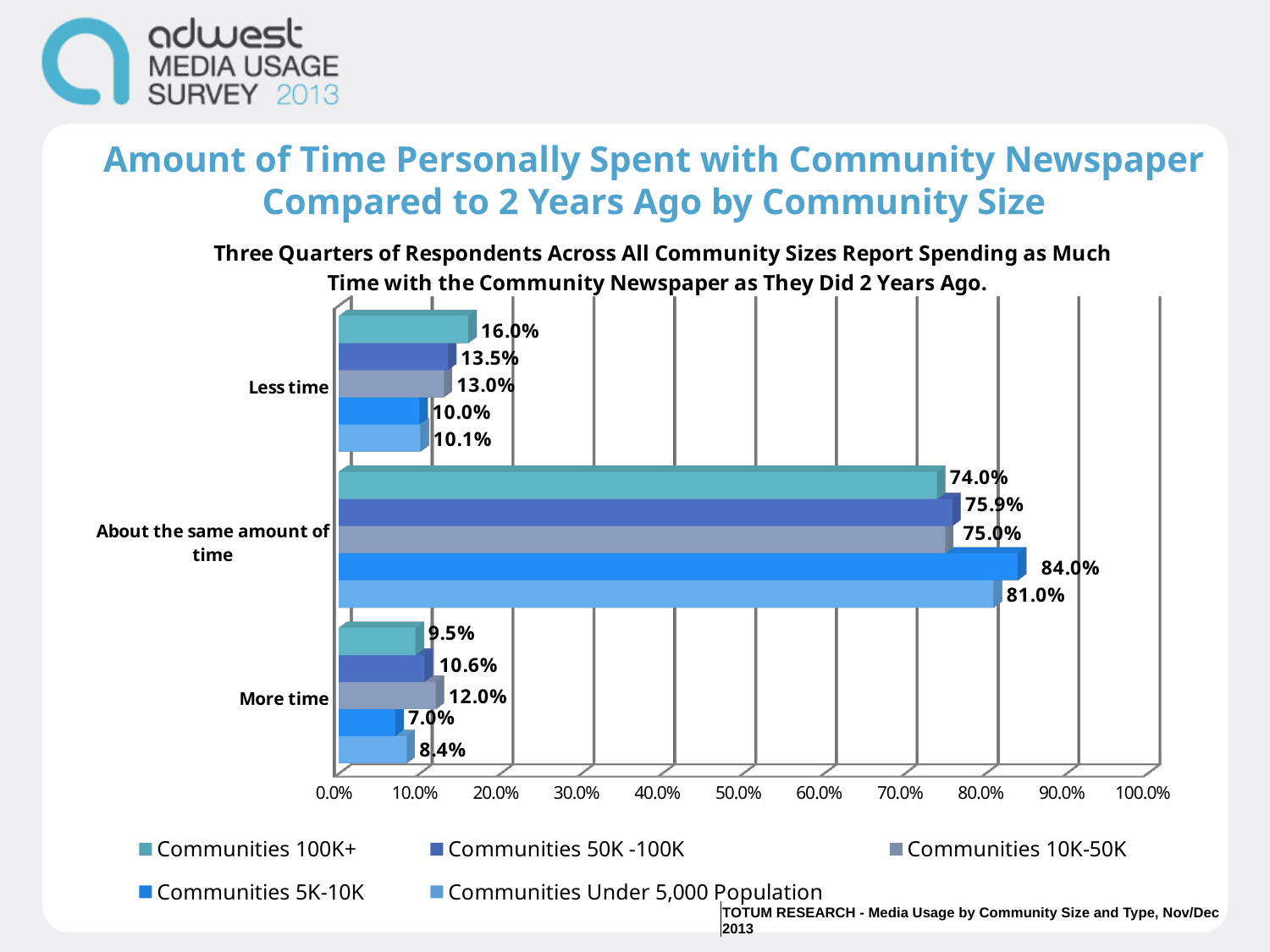
What is the value for Communities 5K-10K in the "About the same amount of time" category? 84.0% How many series does the legend list? 5 In the "Less time" category, which is larger: the value for Communities 100K+ or for Communities 5K-10K? Communities 100K+ What is the highest value shown on the horizontal axis? 100.0% Which community size has the lowest value in the "More time" category? Communities 5K-10K What is the difference between the Communities 5K-10K and Communities 100K+ values in the "About the same amount of time" category? 10.0% How many response categories are shown on the vertical axis? 3 What is the value for Communities 100K+ in the "Less time" category? 16.0% Which community size has the highest value in the "About the same amount of time" category? Communities 5K-10K What is the value for Communities Under 5,000 Population in the "More time" category? 8.4% What is the value for Communities 10K-50K in the "More time" category? 12.0% What kind of chart is shown on the slide? Bar chart